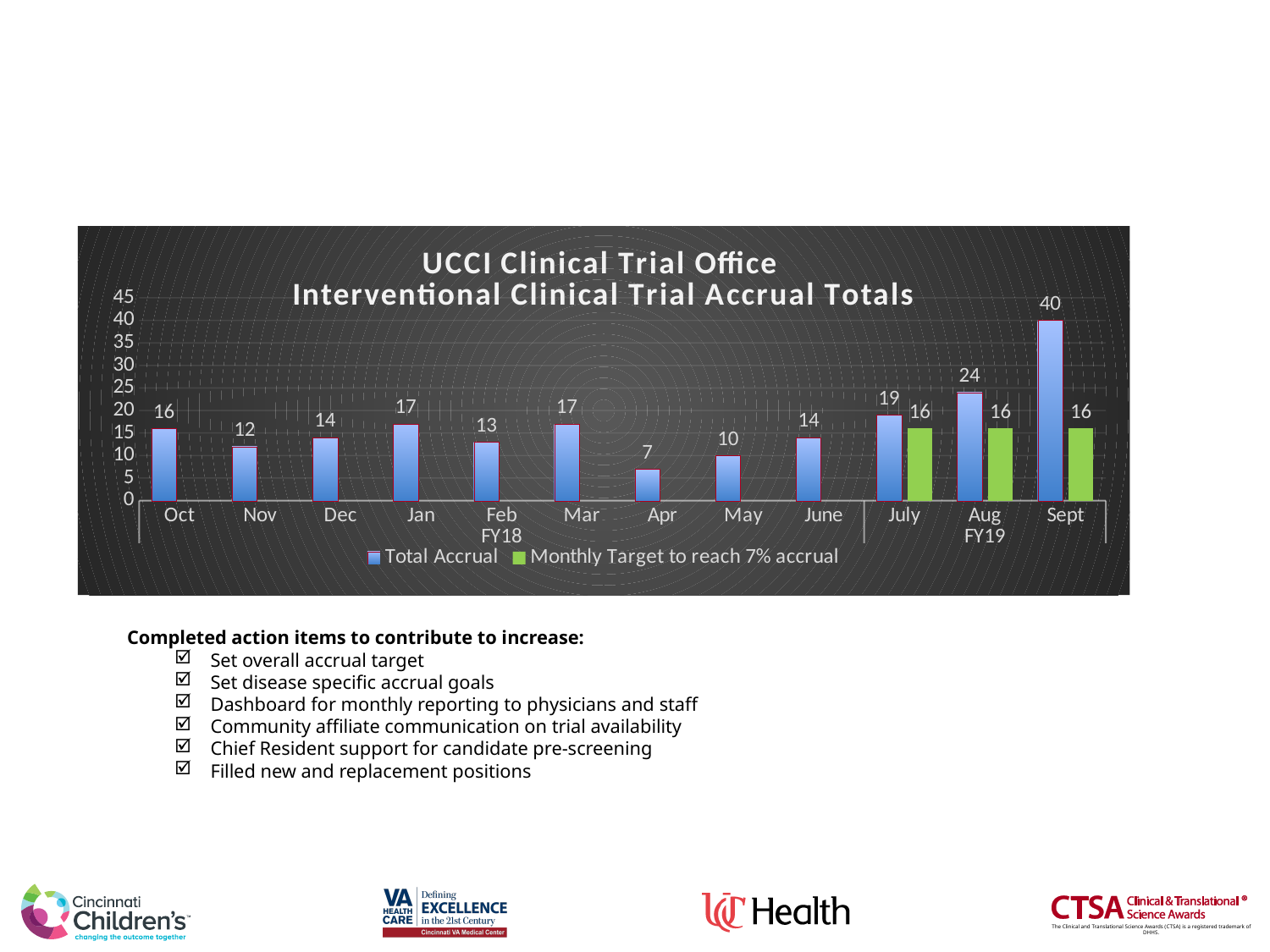
What is the difference between the Total Accrual for July and the Monthly Target for July? 3 What is the Monthly Target to reach 7% accrual value shown for Aug? 16 Which is larger, the Total Accrual for Jan or the Total Accrual for Feb? Jan What is the Total Accrual value for Apr? 7 How many series does the legend list? 2 What is the difference between the Total Accrual for Sept and the Total Accrual for Aug? 16 Which month has the highest Total Accrual? Sept What is the title of the chart? UCCI Clinical Trial Office Interventional Clinical Trial Accrual Totals What kind of chart is shown on the slide? Bar chart Which month has the lowest Total Accrual? Apr How many months are shown on the x axis? 12 What is the Total Accrual value for Sept? 40